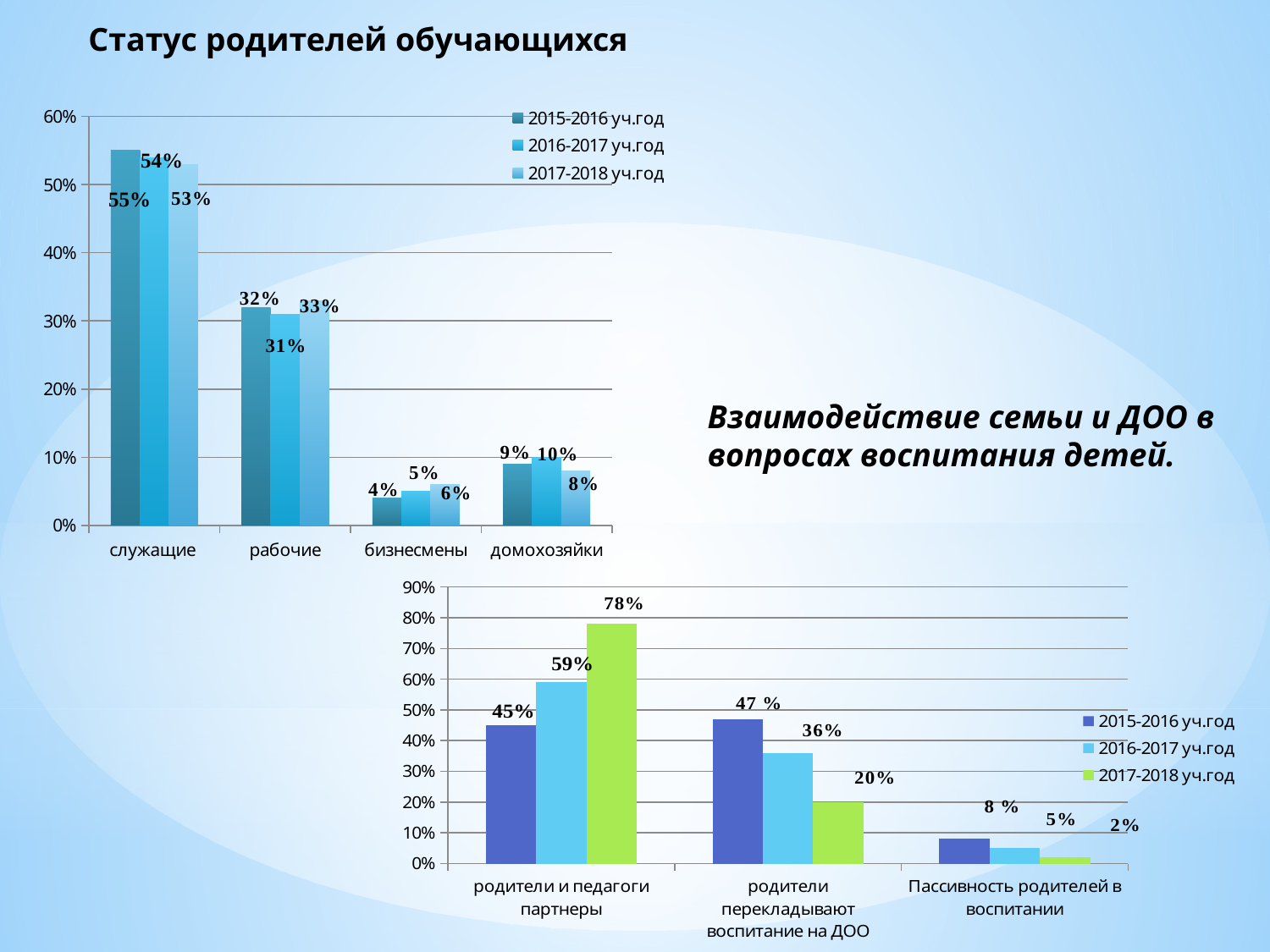
In the chart 'Взаимодействие семьи и ДОО в вопросах воспитания детей', which is larger for 2015-2016 уч.год: 'родители и педагоги партнеры' or 'родители перекладывают воспитание на ДОО'? родители перекладывают воспитание на ДОО In the chart 'Статус родителей обучающихся', what is the value for служащие in 2015-2016 уч.год? 55% In the chart 'Взаимодействие семьи и ДОО в вопросах воспитания детей', does the value for 'родители и педагоги партнеры' rise or fall from 2015-2016 to 2017-2018? rise In the chart 'Статус родителей обучающихся', what is the difference between домохозяйки in 2016-2017 уч.год and домохозяйки in 2017-2018 уч.год? 2% In the chart 'Статус родителей обучающихся', how many categories are shown on the x axis? 4 In the chart 'Взаимодействие семьи и ДОО в вопросах воспитания детей', what is the value for 'родители перекладывают воспитание на ДОО' in 2016-2017 уч.год? 36% In the chart 'Взаимодействие семьи и ДОО в вопросах воспитания детей', what is the value for 'родители и педагоги партнеры' in 2017-2018 уч.год? 78% In the chart 'Статус родителей обучающихся', how many series does the legend list? 3 In the chart 'Взаимодействие семьи и ДОО в вопросах воспитания детей', what is the difference between 'родители и педагоги партнеры' in 2017-2018 уч.год and in 2015-2016 уч.год? 33% In the chart 'Статус родителей обучающихся', what is the value for рабочие in 2017-2018 уч.год? 33% What kind of chart is 'Взаимодействие семьи и ДОО в вопросах воспитания детей'? bar chart In the chart 'Статус родителей обучающихся', which category has the lowest value in 2015-2016 уч.год? бизнесмены